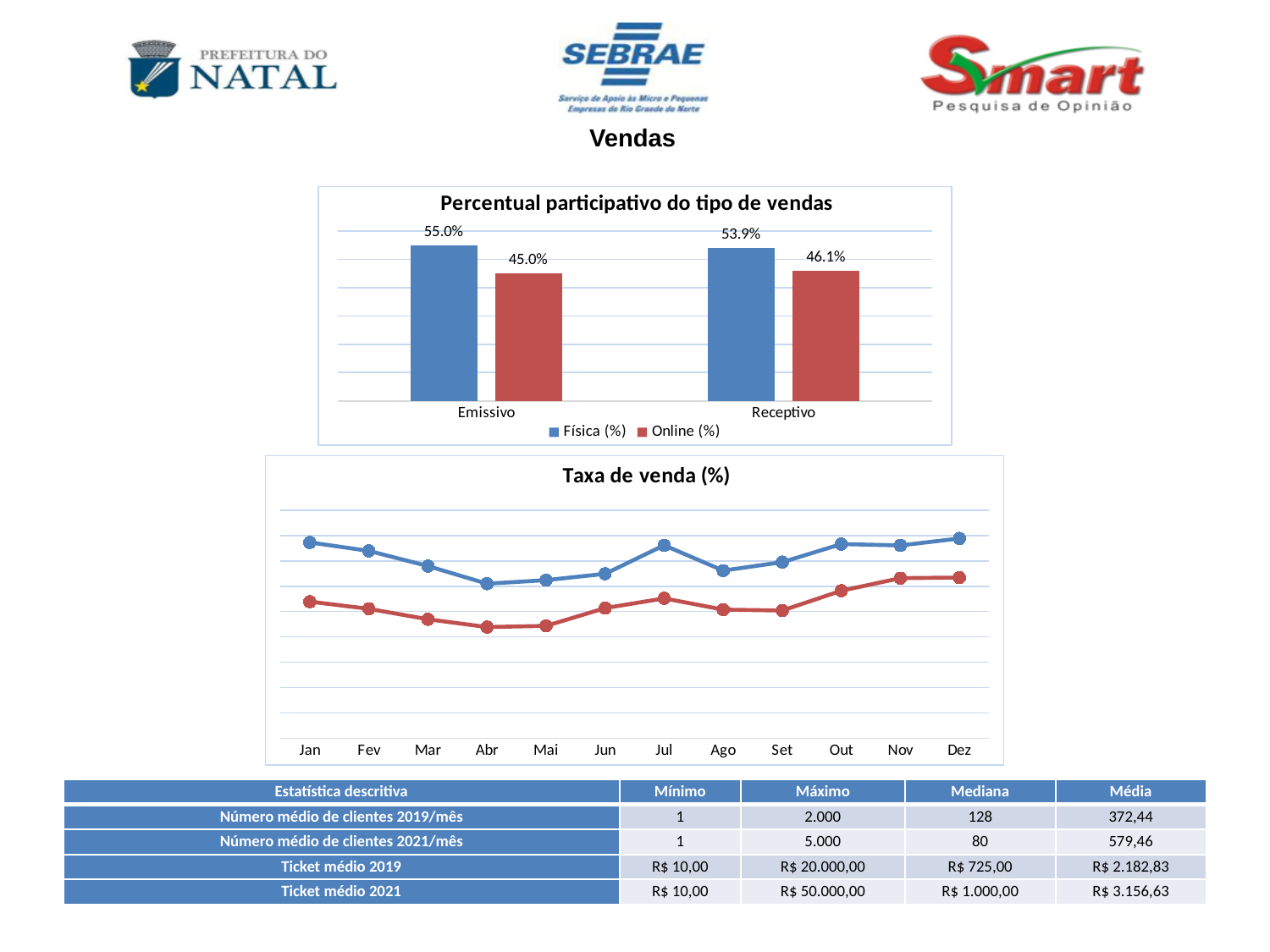
In the chart titled 'Percentual participativo do tipo de vendas', what is the difference between Física (%) and Online (%) for Emissivo? 10.0 percentage points In the chart titled 'Percentual participativo do tipo de vendas', what is the value of Física (%) for Receptivo? 53.9% In the chart titled 'Taxa de venda (%)', how many months are shown on the x axis? 12 In the chart titled 'Taxa de venda (%)', which line is higher in Jul: the blue line or the red line? The blue line What kind of chart is 'Percentual participativo do tipo de vendas'? Bar chart In the chart titled 'Percentual participativo do tipo de vendas', which bar has the highest value? Física (%) for Emissivo What kind of chart is 'Taxa de venda (%)'? Line chart In the chart titled 'Percentual participativo do tipo de vendas', what is the value of Física (%) for Emissivo? 55.0% In the chart titled 'Percentual participativo do tipo de vendas', what is the value of Online (%) for Emissivo? 45.0% In the chart titled 'Percentual participativo do tipo de vendas', which is larger for Receptivo: Física (%) or Online (%)? Física (%) In the chart titled 'Percentual participativo do tipo de vendas', how many series does the legend list? 2 In the chart titled 'Percentual participativo do tipo de vendas', what is the value of Online (%) for Receptivo? 46.1%